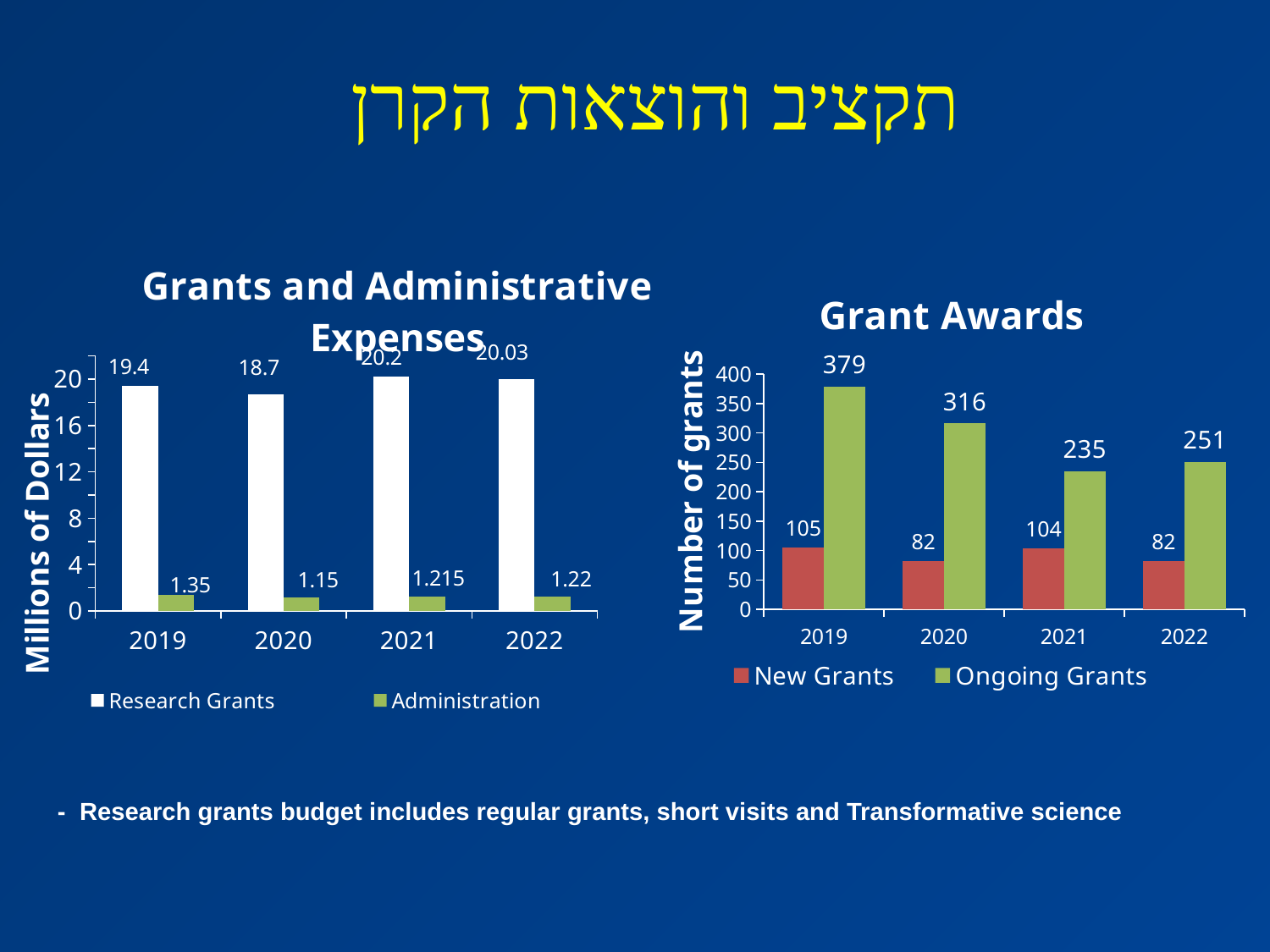
In the Grants and Administrative Expenses chart, what is the value for Administration in 2020? 1.15 In the Grant Awards chart, which year has the lowest Ongoing Grants value? 2021 In the Grant Awards chart, what is the value for New Grants in 2021? 104 In the Grants and Administrative Expenses chart, what is the value for Research Grants in 2019? 19.4 In the Grant Awards chart, what is the difference between Ongoing Grants in 2019 and 2020? 63 In the Grants and Administrative Expenses chart, how many series does the legend list? 2 What kind of chart is the Grant Awards chart? Bar chart In the Grant Awards chart, what is the value for Ongoing Grants in 2019? 379 In the Grants and Administrative Expenses chart, what is the value for Administration in 2022? 1.22 In the Grants and Administrative Expenses chart, which year has the lowest Research Grants value? 2020 In the Grant Awards chart, how many years are shown on the x axis? 4 In the Grants and Administrative Expenses chart, what is the y-axis label? Millions of Dollars